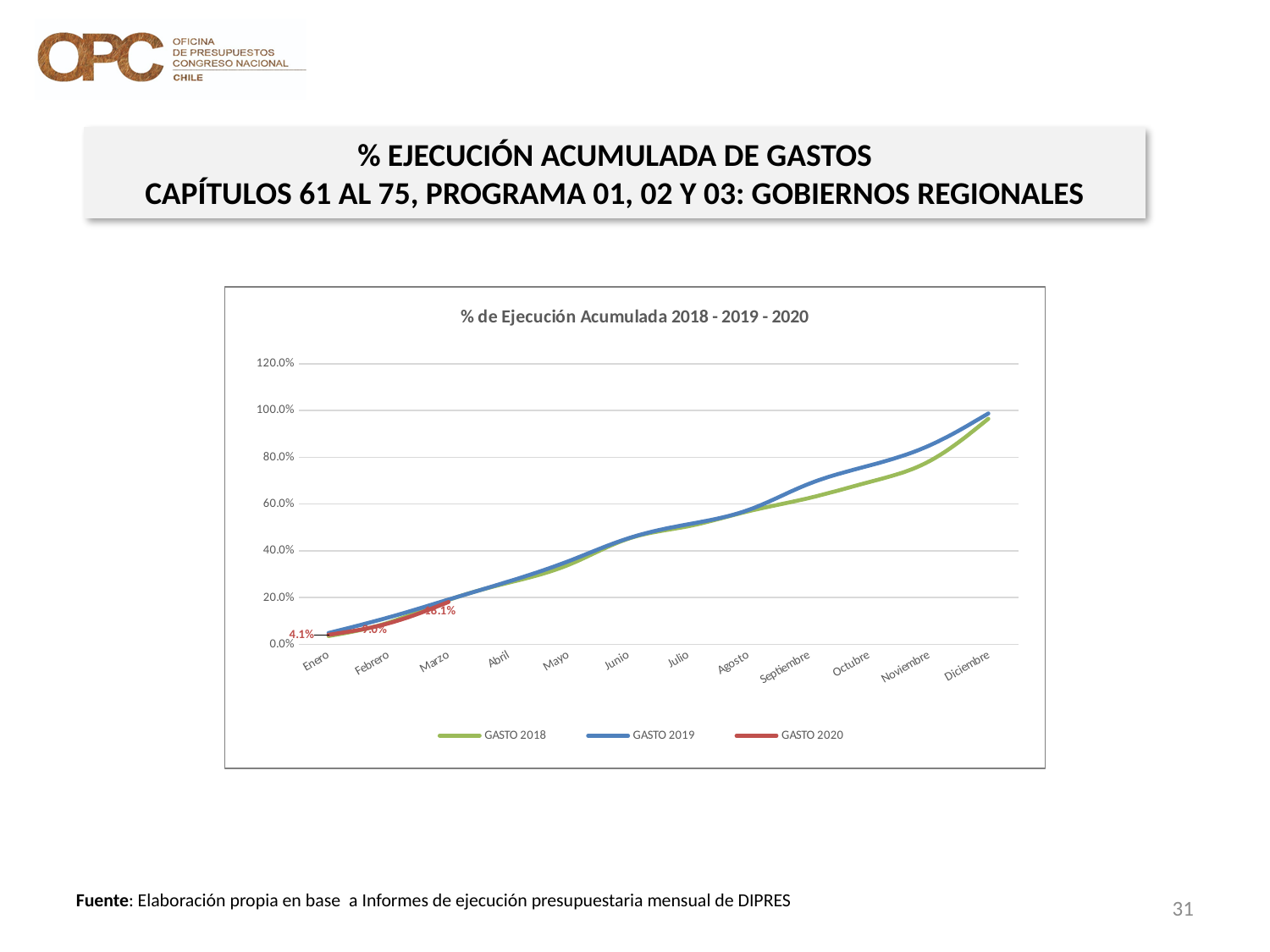
How many series does the legend list? 3 What kind of chart is shown on the slide? Line chart What is the title of the chart? % de Ejecución Acumulada 2018 - 2019 - 2020 Do the GASTO 2019 values rise or fall from Enero to Diciembre? Rise Is the value for GASTO 2019 in Diciembre greater or less than 80%? greater What is the value for GASTO 2020 in Enero? 4.1% How many months are shown on the x axis? 12 Is the value for GASTO 2018 in Enero greater or less than 20%? less Is the value for GASTO 2019 in Junio greater or less than 60%? less For how many months does the GASTO 2020 series have plotted points? 3 In Octubre, which series has the higher value, GASTO 2018 or GASTO 2019? GASTO 2019 What colour is the GASTO 2020 line? Red